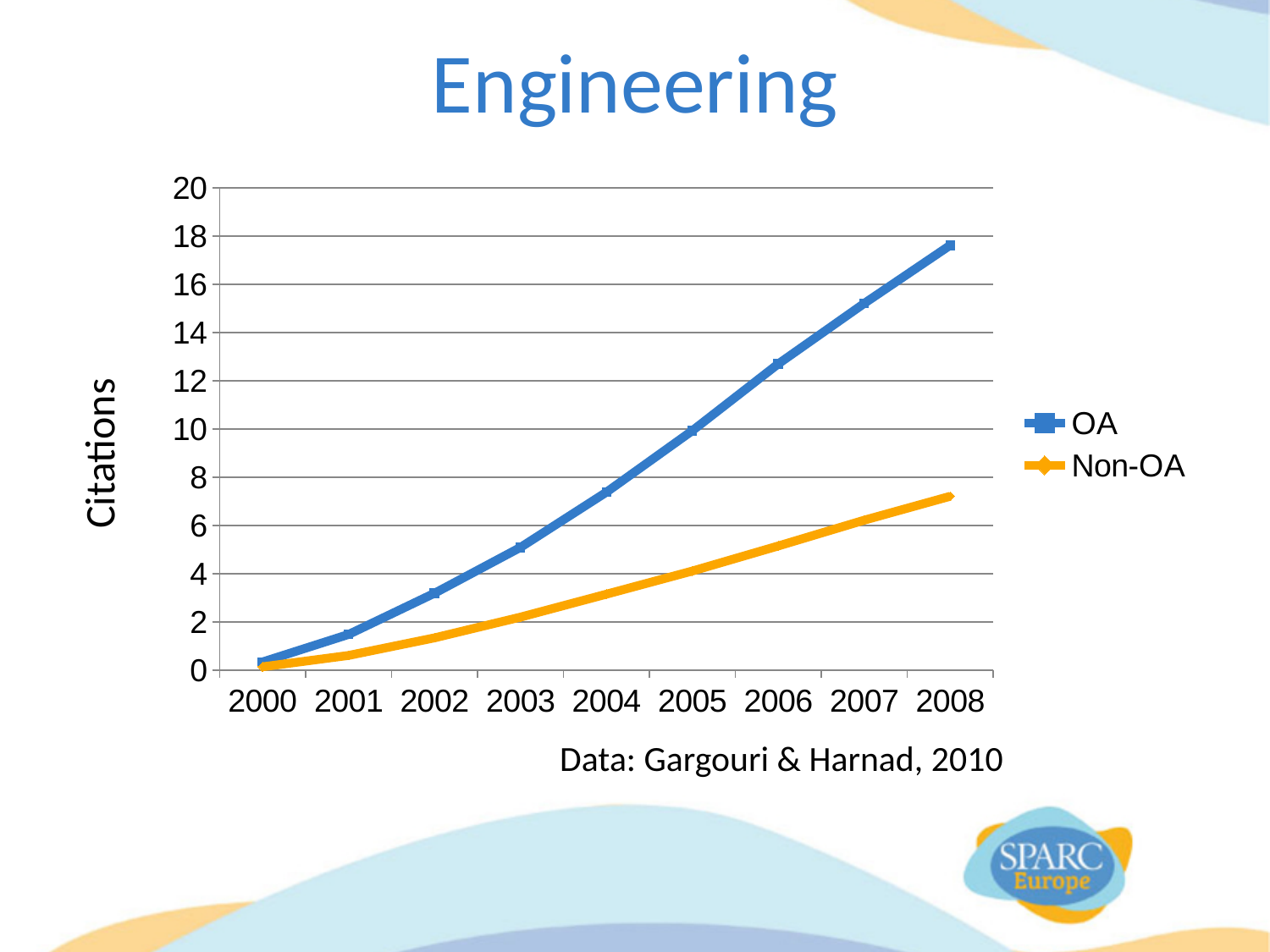
Is the value for Non-OA in 2004 greater or less than 4? less How many years are shown on the x axis? 9 Do the OA citations rise or fall from 2000 to 2008? rise What is the label of the y axis? Citations Which series has the higher value in 2008, OA or Non-OA? OA What kind of chart is shown on the slide? line chart Is the value for OA in 2006 greater or less than 12? greater What is the title of the chart? Engineering How many series does the legend list? 2 Is the value for OA in 2008 greater or less than 16? greater In which year does the OA series reach its highest value? 2008